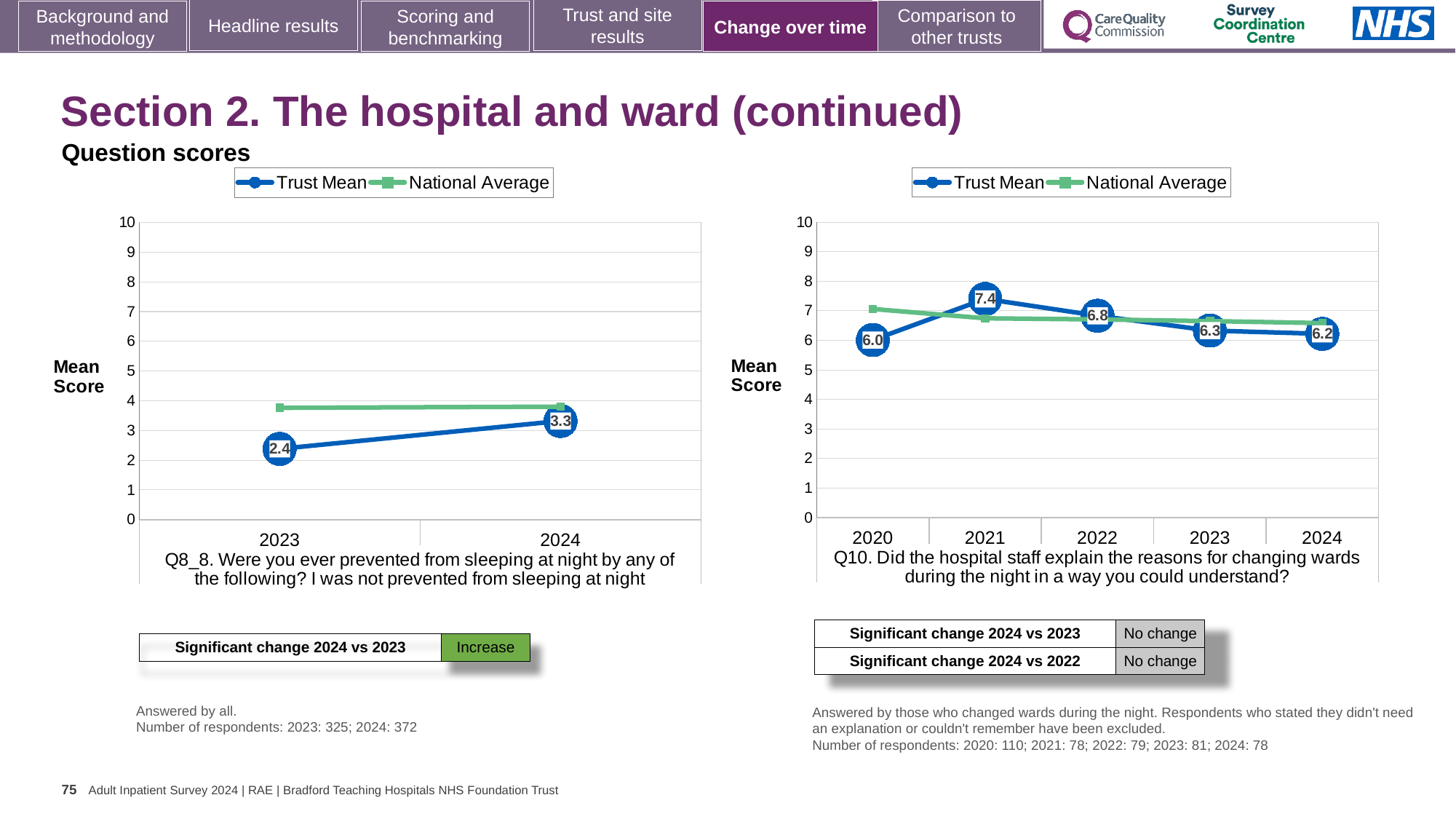
In the left chart (Q8_8), what is the Trust Mean score for 2023? 2.4 In the right chart (Q10), how many series does the legend list? 2 In the left chart (Q8_8), does the Trust Mean rise or fall from 2023 to 2024? rise In the left chart (Q8_8), is the National Average for 2023 greater or less than 3? greater In the left chart (Q8_8), what is the Trust Mean score for 2024? 3.3 In the right chart (Q10), which year has the lowest Trust Mean score? 2020 In the right chart (Q10), what is the difference between the Trust Mean in 2021 and in 2024? 1.2 In the right chart (Q10), what is the Trust Mean score for 2021? 7.4 In the right chart (Q10), how many years are plotted on the x axis? 5 In the right chart (Q10), which year has the highest Trust Mean score? 2021 In the left chart (Q8_8), by how much did the Trust Mean change from 2023 to 2024? 0.9 What type of chart is the left chart (Q8_8)? line chart